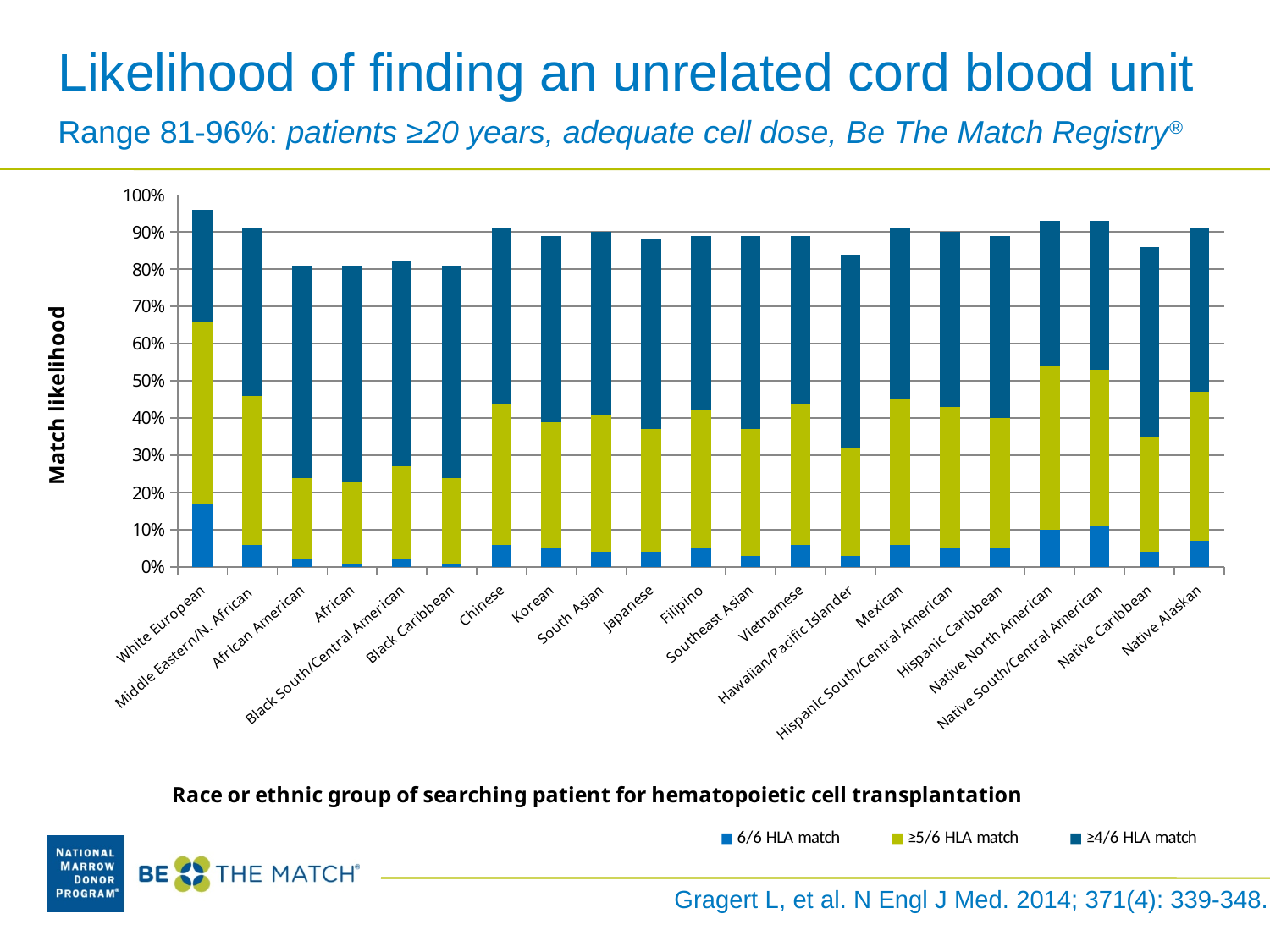
Is the 6/6 HLA match value for White European greater or less than 10%? greater What kind of chart is shown on the slide? Stacked bar chart Is the total match likelihood for African American greater or less than 90%? less Which legend entry is shown in green? ≥5/6 HLA match What is the title of the y axis? Match likelihood Which has a larger total match likelihood, Native North American or Black Caribbean? Native North American Which has a larger total match likelihood, White European or African American? White European Is the total match likelihood for White European greater or less than 90%? greater How many race or ethnic groups are shown along the x axis? 21 Which race or ethnic group has the highest total match likelihood? White European How many series does the legend list? 3